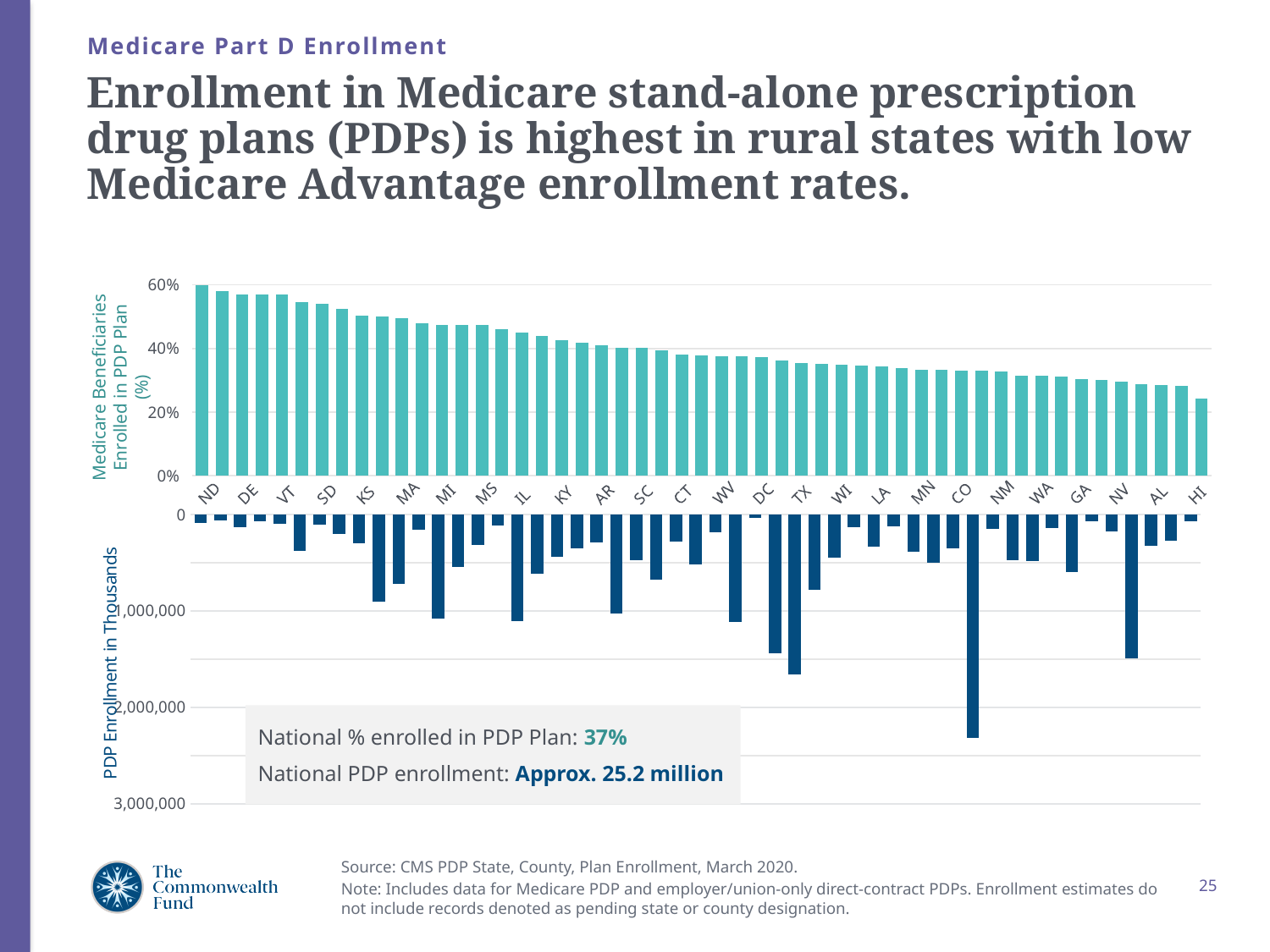
In the top chart, which has a higher percentage enrolled in PDP plans, ND or HI? ND In the top chart, do the percentages rise or fall moving from left to right along the x axis? fall What national percentage enrolled in a PDP plan is stated in the box on the chart? 37% In the top chart, is the value for KS greater or less than 40%? greater What national PDP enrollment figure is stated in the box on the chart? Approx. 25.2 million In the top chart, is the value for ND greater or less than 40%? greater In the bottom chart (PDP Enrollment in Thousands), is the enrollment for TX greater or less than 1,000,000? greater What kind of chart is used on this slide? Bar chart How many state labels are shown on the x axis of the chart? 26 In the top chart (Medicare Beneficiaries Enrolled in PDP Plan), which labeled state has the lowest percentage? HI In the top chart (Medicare Beneficiaries Enrolled in PDP Plan), which state has the highest percentage? ND